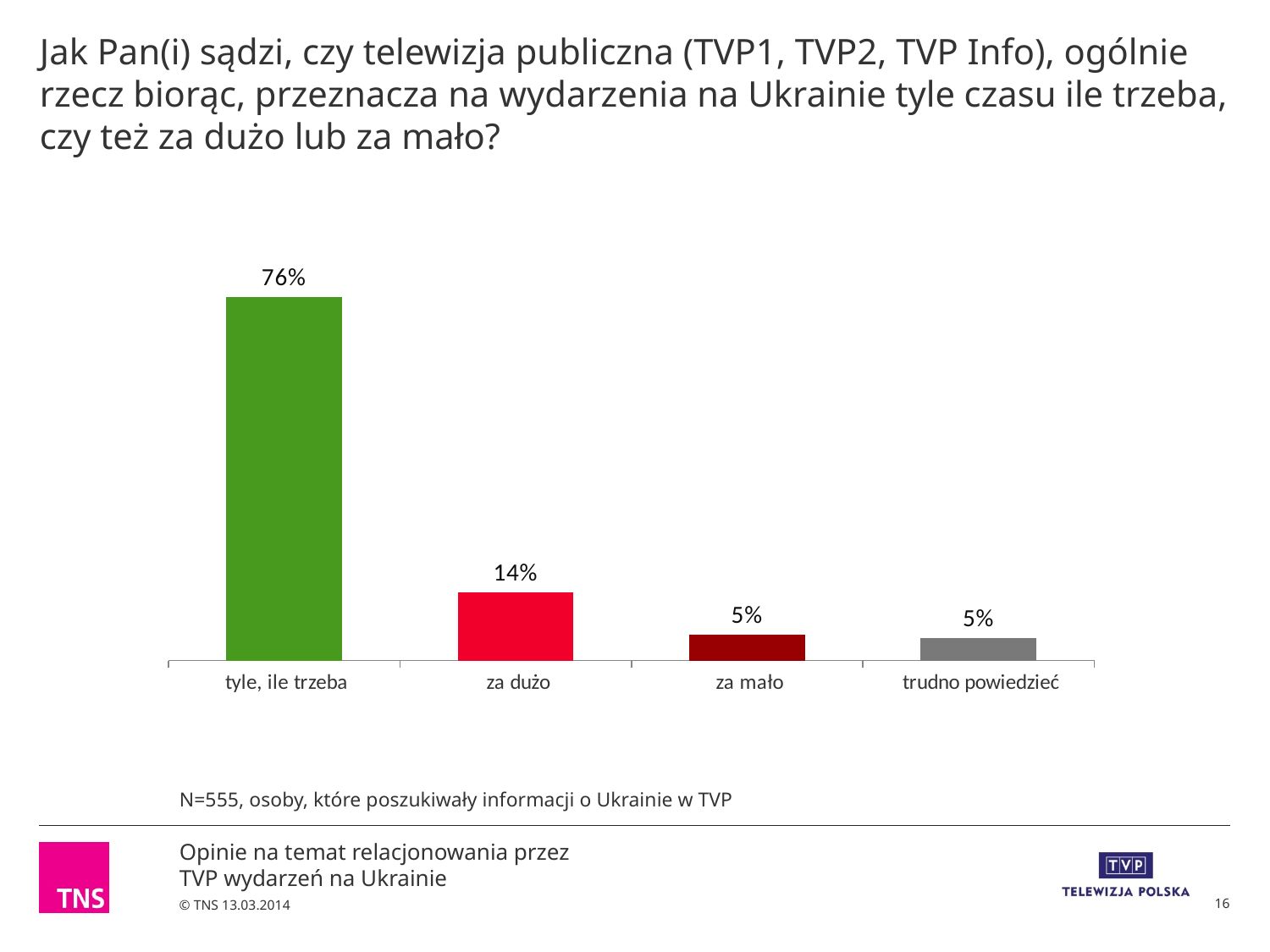
What is the difference between the values for "za dużo" and "za mało"? 9% What is the sample size (N) stated below the chart? N=555 What is the value for "za dużo"? 14% What colour is the bar for "tyle, ile trzeba"? green How many categories are shown in the chart? 4 What is the value for "trudno powiedzieć"? 5% What is the value for "tyle, ile trzeba"? 76% What is the difference between the values for "tyle, ile trzeba" and "za dużo"? 62% What is the value for "za mało"? 5% Which is larger, the value for "za dużo" or the value for "za mało"? za dużo What kind of chart is shown on the slide? bar chart Which category has the highest value? tyle, ile trzeba